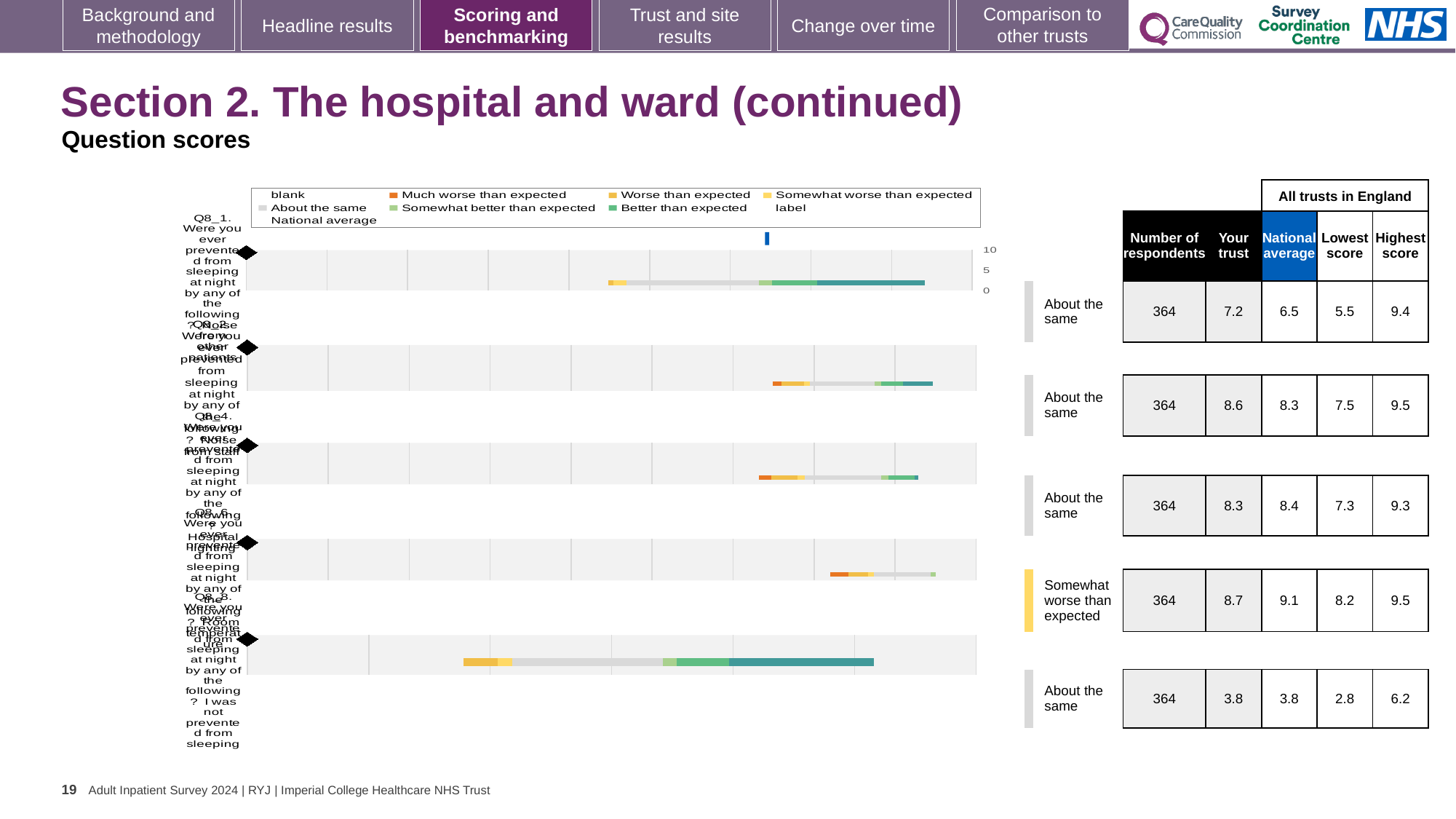
In the table beside the chart, which row has the lowest 'Your trust' score? Q8_8 (3.8) How many benchmark categories, from 'Much worse than expected' to 'Better than expected', does the chart legend list? 6 What kind of chart is shown on the slide? bar chart Which legend entry in the chart is shown in orange-red? Much worse than expected How many of the five question rows are rated 'About the same'? 4 In the table beside the chart, what is the difference between the highest score and lowest score for the last row (Q8_8)? 3.4 In the table beside the chart, what is the 'Your trust' score for the first row (Q8_1)? 7.2 How many question rows (bars) does the chart show? 5 What benchmark result is shown for the first bar (Q8_1) in the chart? About the same In the table beside the chart, how many respondents are listed for each question? 364 In the table beside the chart, what is the national average for the fourth row (Q8_6)? 9.1 What benchmark result is shown for the fourth bar (Q8_6) in the chart? Somewhat worse than expected